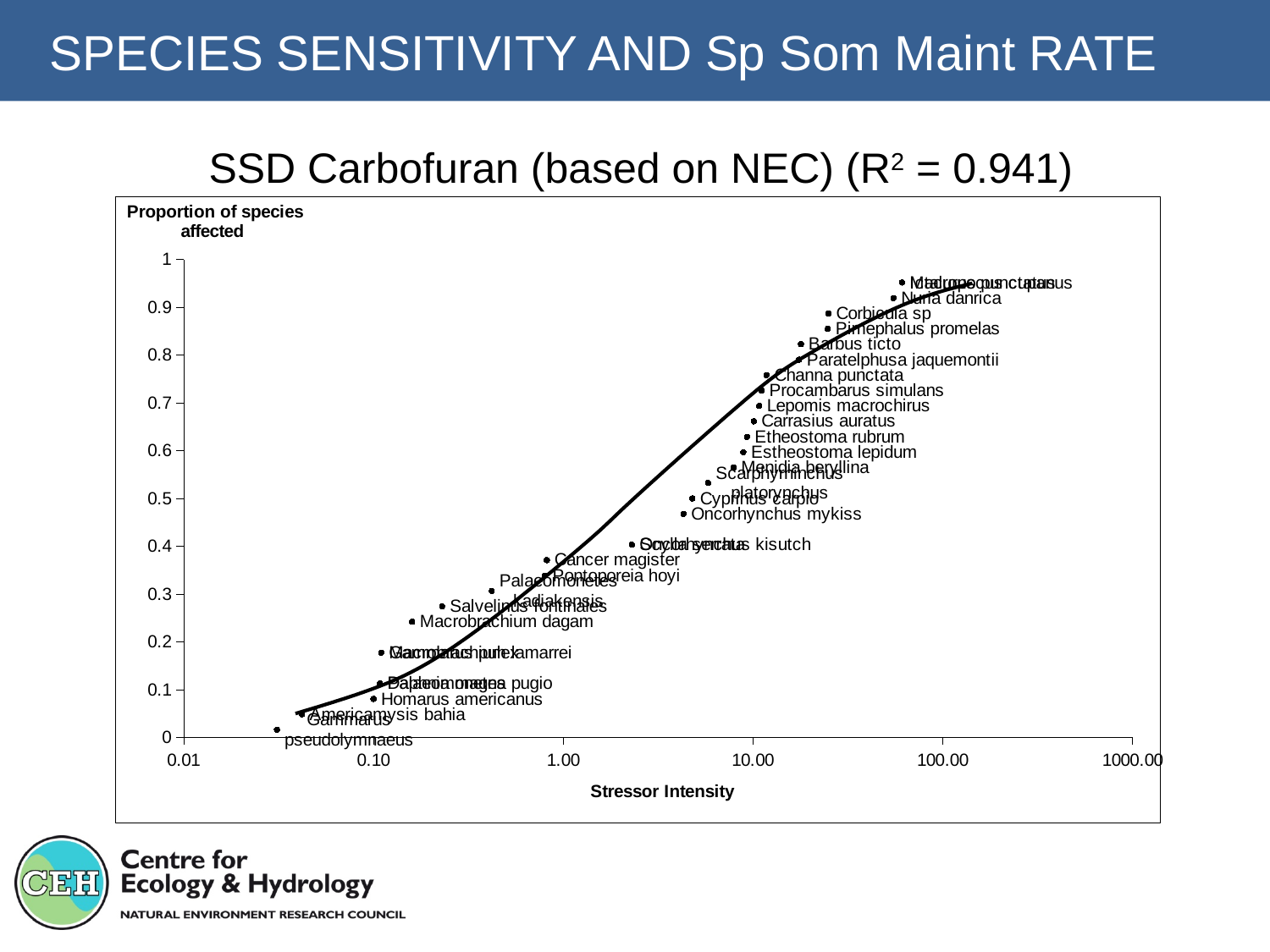
Is the proportion of species affected for Pontoporeia hoyi greater or less than 0.3? greater Which has a higher proportion of species affected, Oncorhynchus mykiss or Cancer magister? Oncorhynchus mykiss What is the title of the chart? SSD Carbofuran (based on NEC) (R² = 0.941) Is the stressor intensity for Corbicula sp greater or less than 10.00? greater Is the proportion of species affected for Macrobrachium dagam greater or less than 0.3? less What is the label of the x axis? Stressor Intensity What kind of chart is shown on the slide? scatter plot